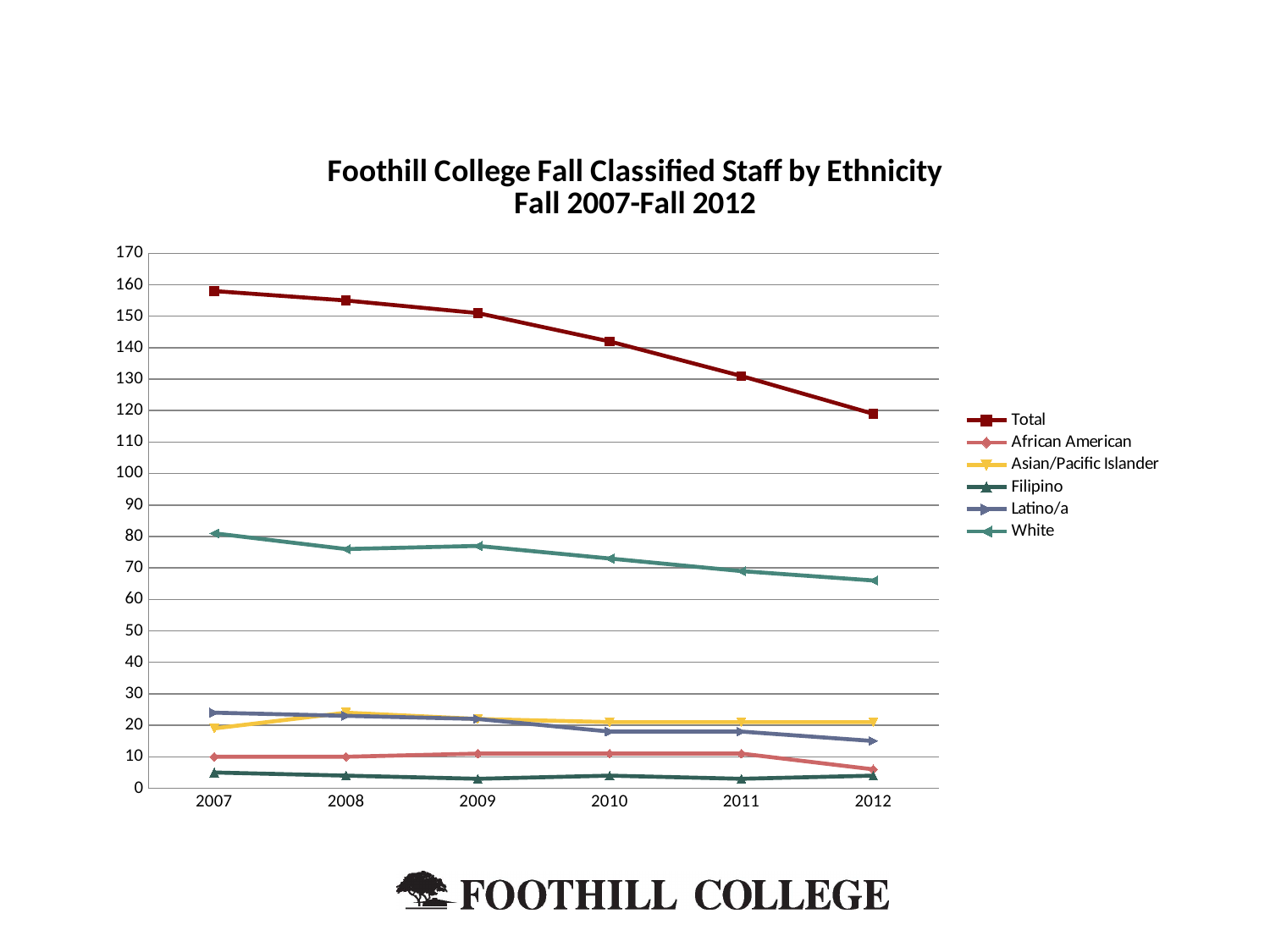
Is the value for Total in 2007 greater or less than 150? greater Is the value for Latino/a in 2012 greater or less than 20? less How many series does the legend list? 6 What kind of chart is shown on the slide? line chart In 2010, which is larger: the value for White or the value for Latino/a? White What is the title of the chart? Foothill College Fall Classified Staff by Ethnicity Fall 2007-Fall 2012 In 2012, which is larger: the value for Asian/Pacific Islander or the value for Latino/a? Asian/Pacific Islander Does the Total series rise or fall from 2007 to 2012? fall Is the value for Total in 2012 greater or less than 130? less Which series has the lowest value in 2007? Filipino How many years are plotted along the x axis? 6